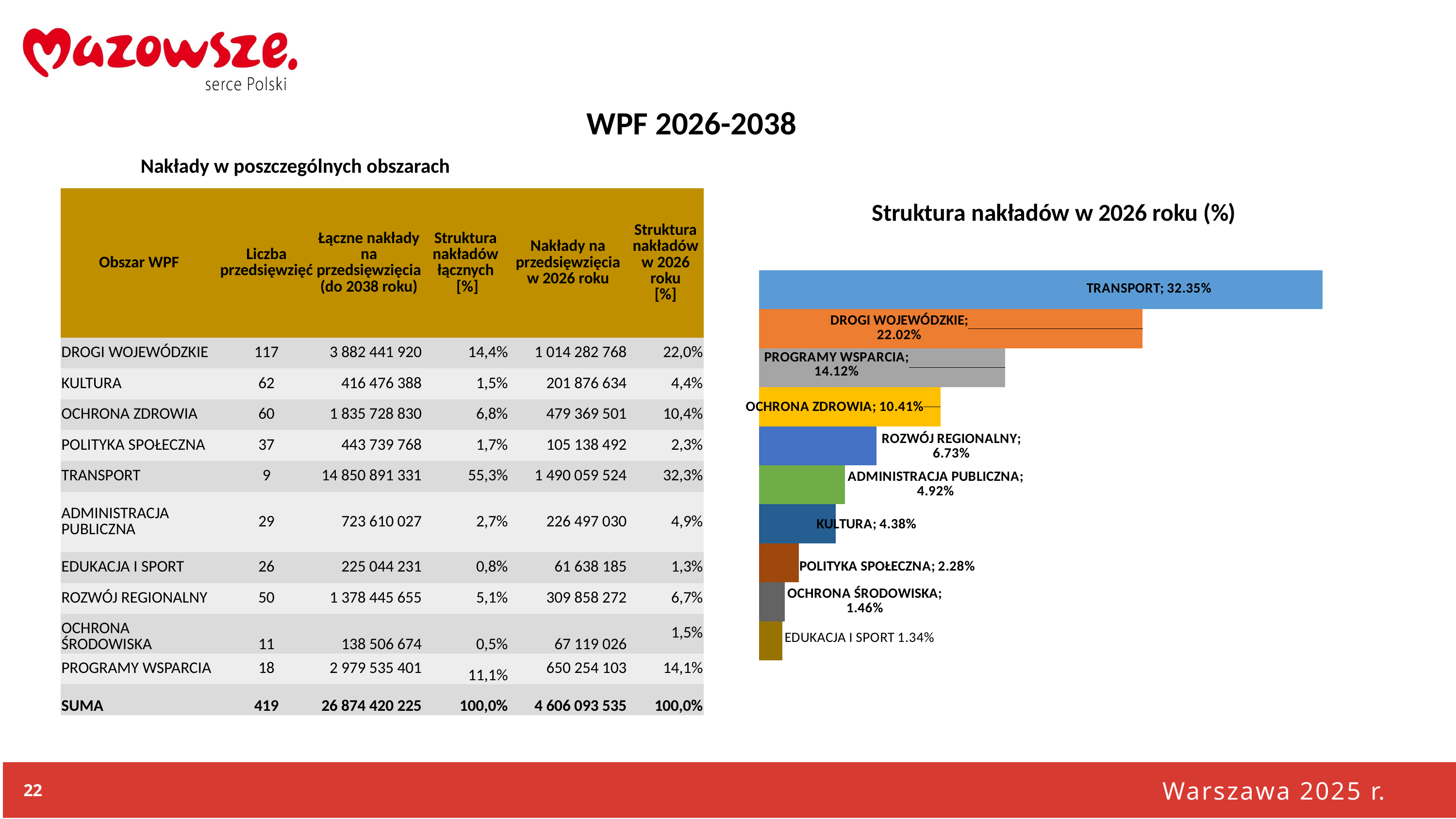
What kind of chart is "Struktura nakładów w 2026 roku (%)"? Bar chart What is the title of the chart on the right side of the slide? Struktura nakładów w 2026 roku (%) Which category has the highest value in the chart "Struktura nakładów w 2026 roku (%)"? TRANSPORT In the chart "Struktura nakładów w 2026 roku (%)", what is the difference between the values for TRANSPORT and DROGI WOJEWÓDZKIE? 10.33% Which category has the lowest value in the chart "Struktura nakładów w 2026 roku (%)"? EDUKACJA I SPORT What is the value for OCHRONA ZDROWIA in the chart "Struktura nakładów w 2026 roku (%)"? 10.41% What is the value for TRANSPORT in the chart "Struktura nakładów w 2026 roku (%)"? 32.35% What is the value for PROGRAMY WSPARCIA in the chart "Struktura nakładów w 2026 roku (%)"? 14.12% In the chart "Struktura nakładów w 2026 roku (%)", what is the difference between the values for ROZWÓJ REGIONALNY and ADMINISTRACJA PUBLICZNA? 1.81% In the chart "Struktura nakładów w 2026 roku (%)", which is larger: the value for PROGRAMY WSPARCIA or the value for OCHRONA ZDROWIA? PROGRAMY WSPARCIA What is the value for KULTURA in the chart "Struktura nakładów w 2026 roku (%)"? 4.38% How many categories are shown in the chart "Struktura nakładów w 2026 roku (%)"? 10